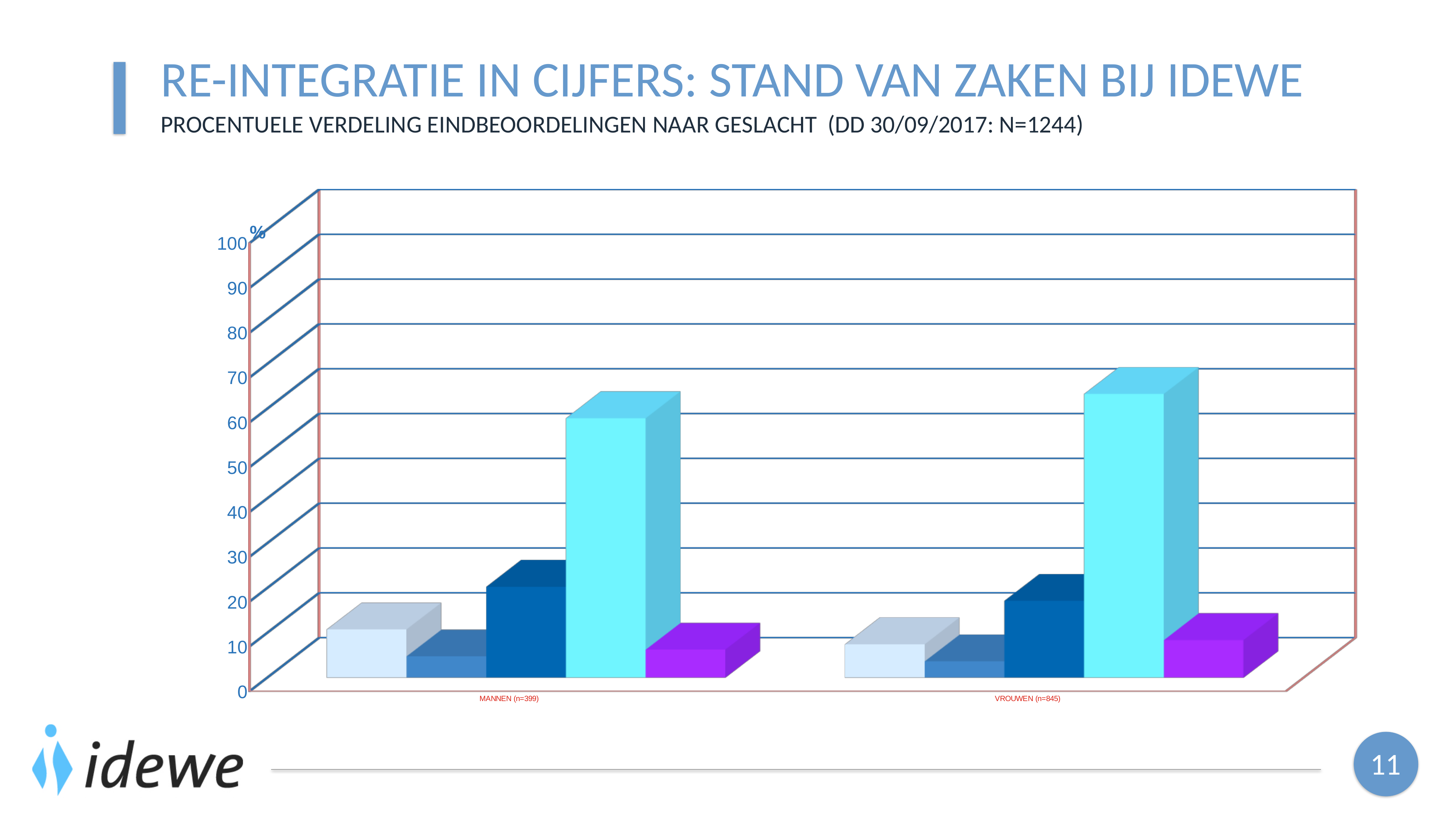
What are the two category labels on the x axis of the chart? MANNEN (n=399) and VROUWEN (n=845) How many categories are shown on the x axis of the chart? 2 Is the value of the purple bar for VROUWEN (n=845) greater or less than 20? less Is the value of the dark blue bar for MANNEN (n=399) greater or less than 10? greater Is the value of the tallest (cyan) bar for MANNEN (n=399) greater or less than 50? greater Which coloured bar is the lowest within the MANNEN (n=399) group? the medium blue (second) bar What kind of chart is shown on the slide? bar chart What unit is shown on the vertical axis of the chart? % Which is larger: the dark blue bar for MANNEN (n=399) or the dark blue bar for VROUWEN (n=845)? MANNEN (n=399) Which is larger: the cyan bar for MANNEN (n=399) or the cyan bar for VROUWEN (n=845)? VROUWEN (n=845)